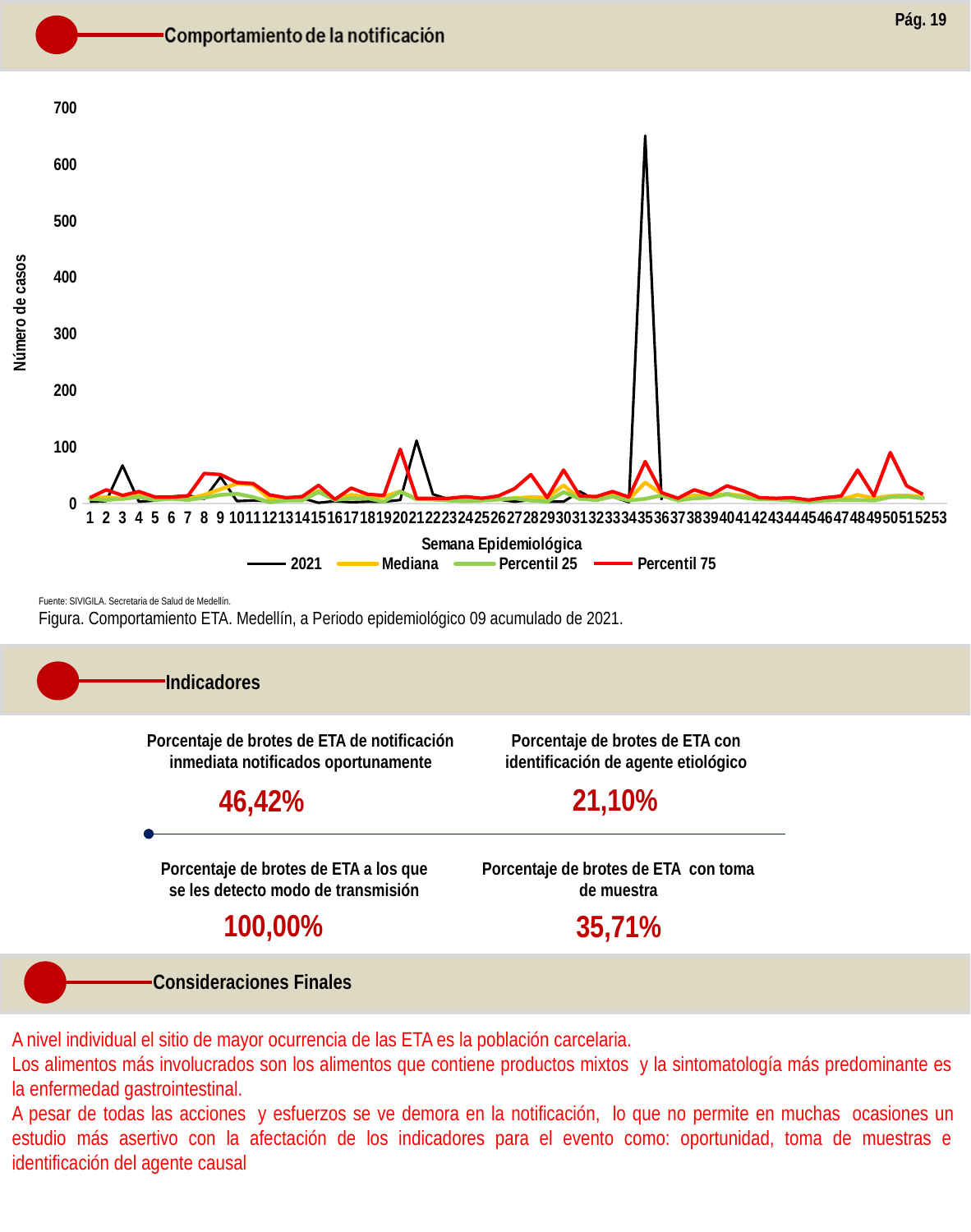
In week 35, which series has the larger value, 2021 or Percentil 75? 2021 How many epidemiological weeks are shown on the x axis of the chart? 53 Which series reaches the highest value anywhere on the chart? 2021 Is the value of the Percentil 75 series in week 35 greater or less than 100? less What kind of chart is shown on the slide? line chart What is the title of the chart's x axis? Semana Epidemiológica Is the value of the 2021 series in week 35 greater or less than 600? greater How many series does the chart legend list? 4 Is the value of the 2021 series in week 3 greater or less than 100? less In which epidemiological week does the 2021 series reach its highest value? 35 What are the series names listed in the chart legend? 2021, Mediana, Percentil 25, Percentil 75